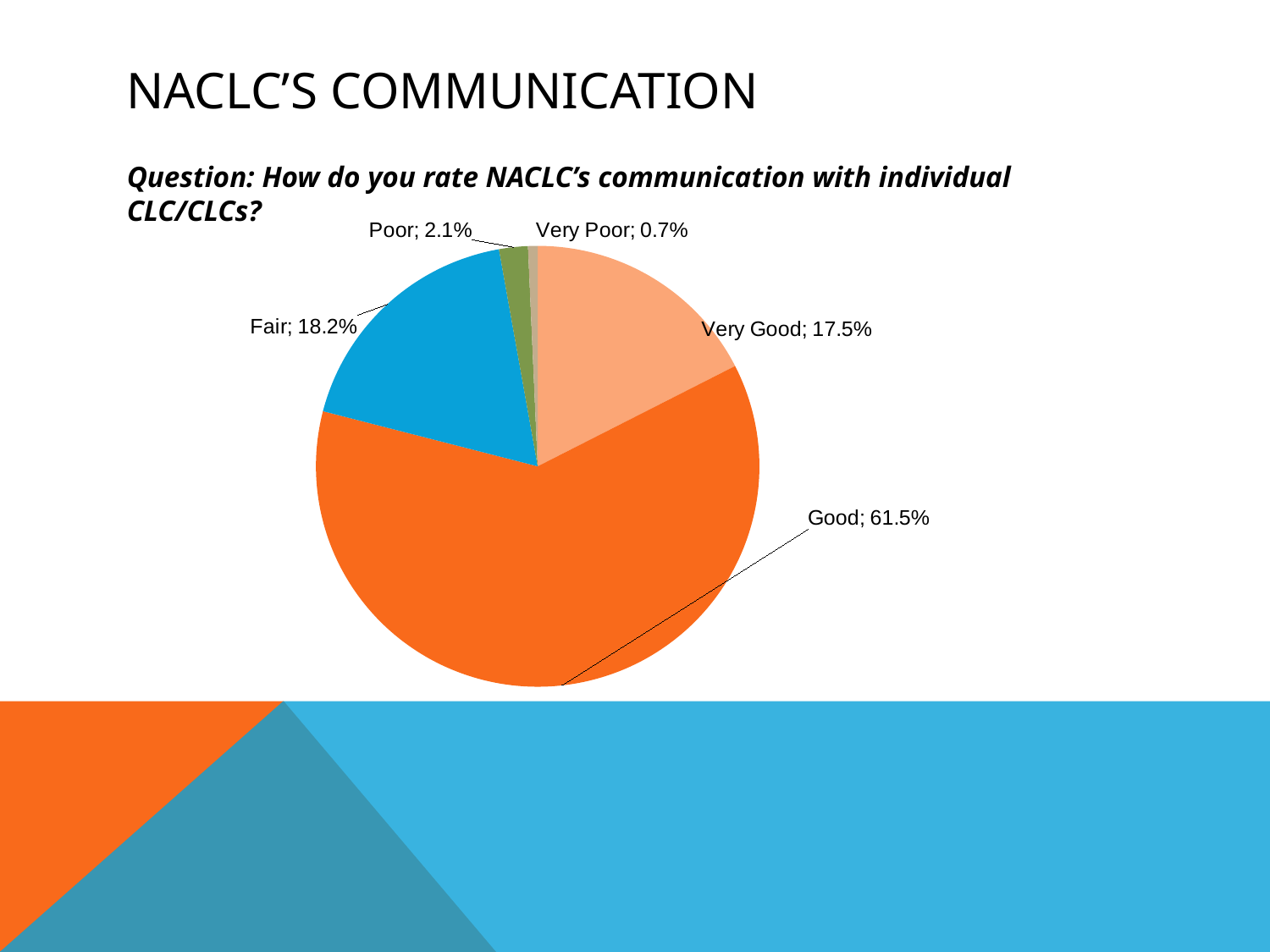
Which rating category has the largest share of the pie? Good What percentage of respondents rated NACLC's communication as Poor? 2.1% What percentage of respondents rated NACLC's communication as Very Good? 17.5% What is the difference in percentage points between the Good and Very Good shares? 44.0% What percentage of respondents rated NACLC's communication as Very Poor? 0.7% How many rating categories are shown in the pie chart? 5 What is the combined share of the Poor and Very Poor categories? 2.8% Which is larger, the Fair share or the Very Good share? Fair What percentage of respondents rated NACLC's communication as Fair? 18.2% What percentage of respondents rated NACLC's communication as Good? 61.5% Which rating category has the smallest share of the pie? Very Poor What kind of chart is shown on the slide? pie chart